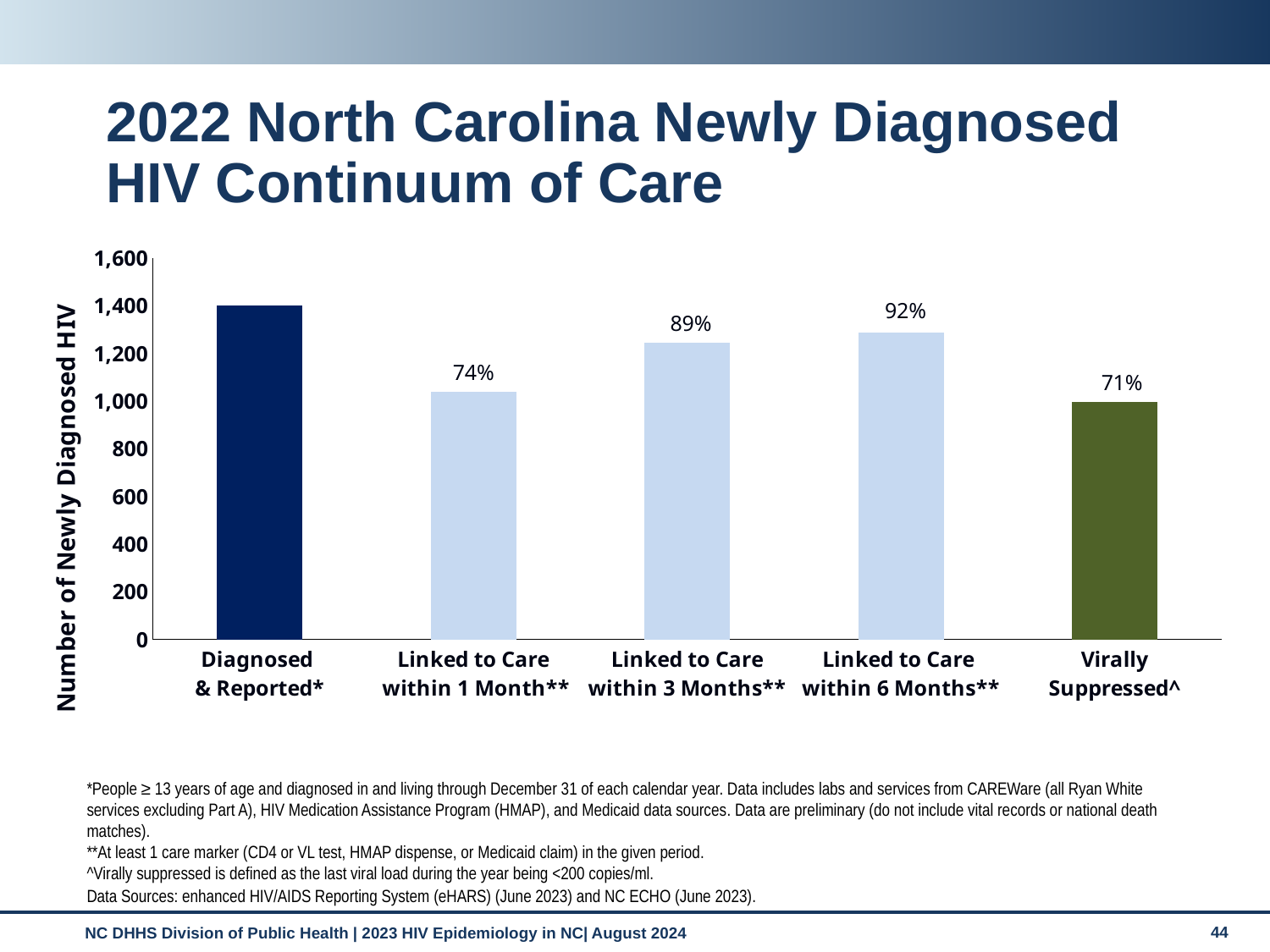
What percentage label is shown above the 'Virally Suppressed^' bar? 71% Which bar is taller: 'Linked to Care within 3 Months**' or 'Virally Suppressed^'? Linked to Care within 3 Months** What percentage label is shown above the 'Linked to Care within 3 Months**' bar? 89% Which category has the tallest bar in the chart? Diagnosed & Reported* Is the value for 'Diagnosed & Reported*' greater or less than 1,200? greater What percentage label is shown above the 'Linked to Care within 1 Month**' bar? 74% Is the value for 'Linked to Care within 1 Month**' greater or less than 1,200? less How many categories are shown on the x axis of the chart? 5 Among the bars with percentage labels, which category has the lowest percentage? Virally Suppressed^ What type of chart is shown on the slide? Bar chart What is the difference in percentage points between the 'Linked to Care within 6 Months**' label and the 'Linked to Care within 1 Month**' label? 18 percentage points What percentage label is shown above the 'Linked to Care within 6 Months**' bar? 92%